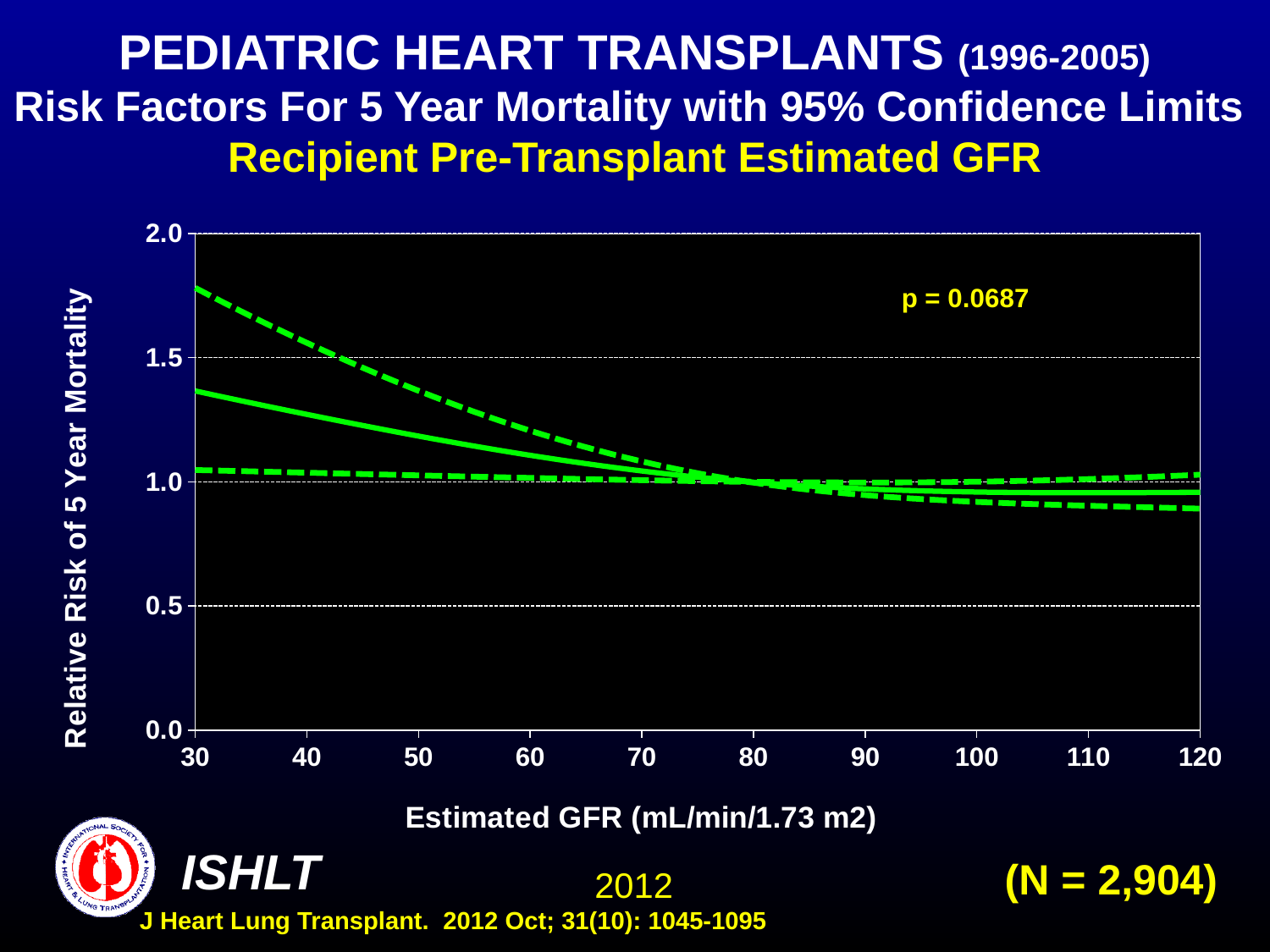
Is the solid line's relative risk at an estimated GFR of 60 greater or less than 1.0? greater What p-value is printed on the chart? p = 0.0687 What is the N shown on the slide? N = 2,904 Is the solid line's relative risk larger at an estimated GFR of 30 or at 120? 30 Is the upper dashed confidence limit at an estimated GFR of 60 greater or less than 1.5? less How many lines are plotted on the chart? 3 Is the upper dashed confidence limit at an estimated GFR of 30 greater or less than 1.5? greater Does the solid line (relative risk) rise or fall as estimated GFR increases from 30 to 120? fall What kind of chart is shown on the slide? line chart How many tick labels are shown on the x axis? 10